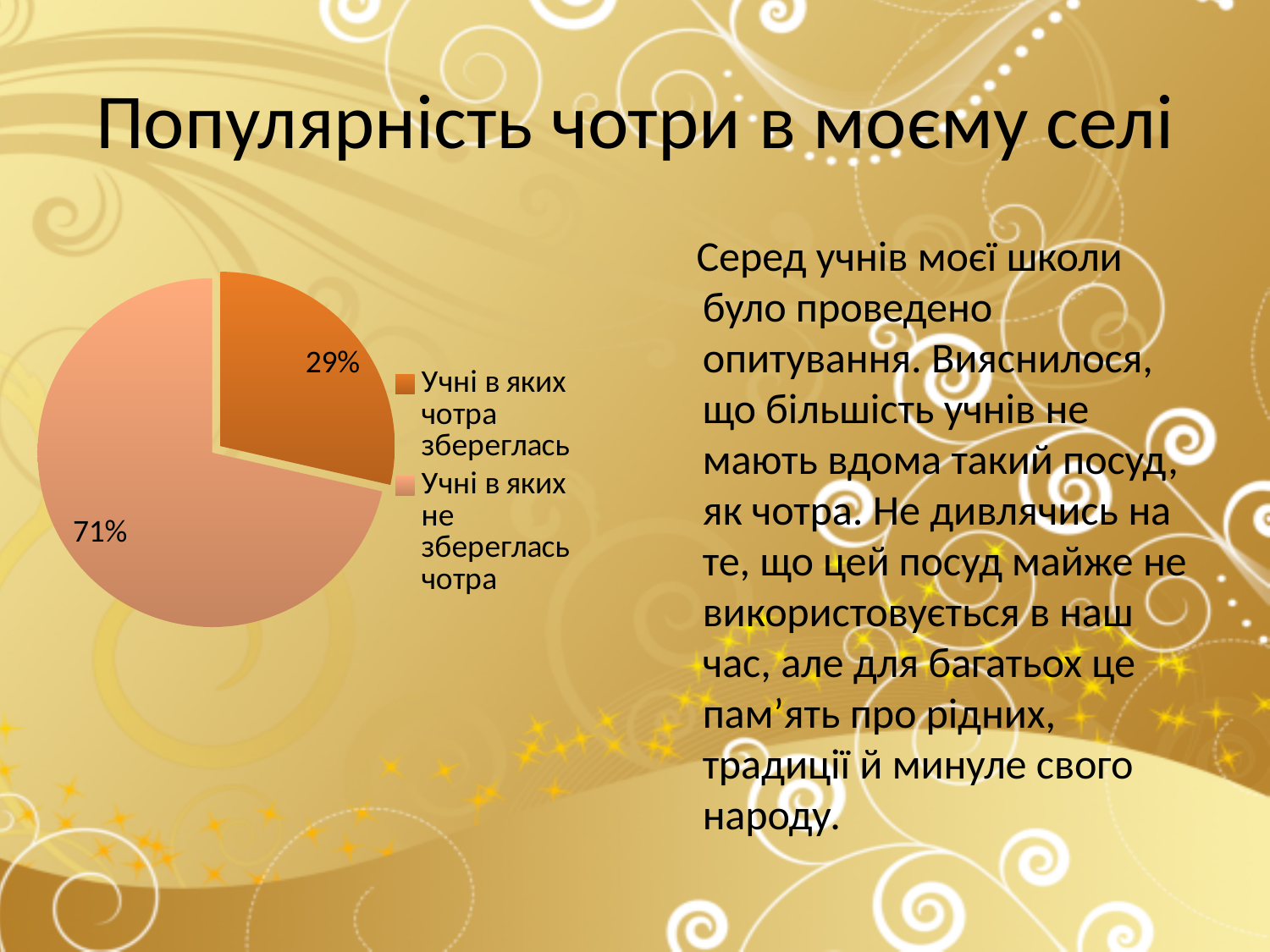
What kind of chart is shown on the slide? pie chart Which is larger: the slice for "Учні в яких чотра збереглась" or the slice for "Учні в яких не збереглась чотра"? Учні в яких не збереглась чотра Which slice of the pie is the smallest? Учні в яких чотра збереглась On which side of the pie chart is the legend placed? right Which legend entry is shown in the darker orange colour? Учні в яких чотра збереглась What share of the pie is labelled "Учні в яких не збереглась чотра"? 71% How many entries does the legend list? 2 Which slice of the pie is the largest? Учні в яких не збереглась чотра How many slices does the pie chart have? 2 Is the share for "Учні в яких не збереглась чотра" greater or less than 50%? greater What is the difference in percentage points between the two slices of the pie? 42 What share of the pie is labelled "Учні в яких чотра збереглась"? 29%